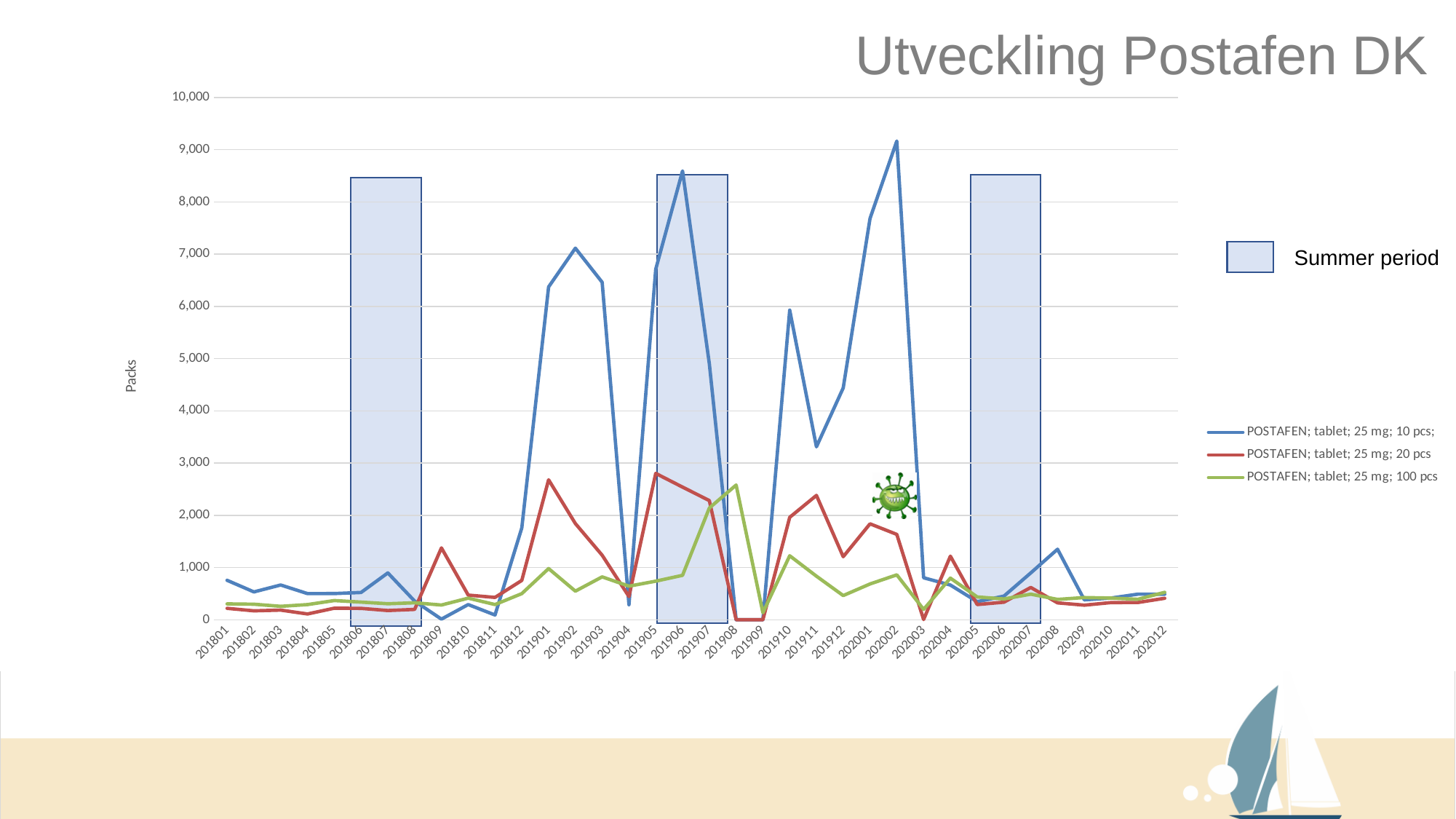
In which month does the POSTAFEN; tablet; 25 mg; 100 pcs series reach its highest value? 201908 In 201908, which series has the larger value: POSTAFEN; tablet; 25 mg; 100 pcs or POSTAFEN; tablet; 25 mg; 10 pcs? POSTAFEN; tablet; 25 mg; 100 pcs Is the value for POSTAFEN; tablet; 25 mg; 10 pcs in 201809 greater or less than 1,000? less Is the value for POSTAFEN; tablet; 25 mg; 20 pcs in 201905 greater or less than 2,000? greater Does the POSTAFEN; tablet; 25 mg; 10 pcs series rise or fall from 201911 to 202002? rise In 201906, which series has the larger value: POSTAFEN; tablet; 25 mg; 10 pcs or POSTAFEN; tablet; 25 mg; 20 pcs? POSTAFEN; tablet; 25 mg; 10 pcs In which month does the POSTAFEN; tablet; 25 mg; 10 pcs series reach its highest value? 202002 How many months are plotted along the x axis? 36 How many series does the legend list? 3 What do the shaded blue rectangles on the chart represent? Summer period Is the value for POSTAFEN; tablet; 25 mg; 10 pcs in 202002 greater or less than 8,000? greater What kind of chart is shown on the slide? line chart